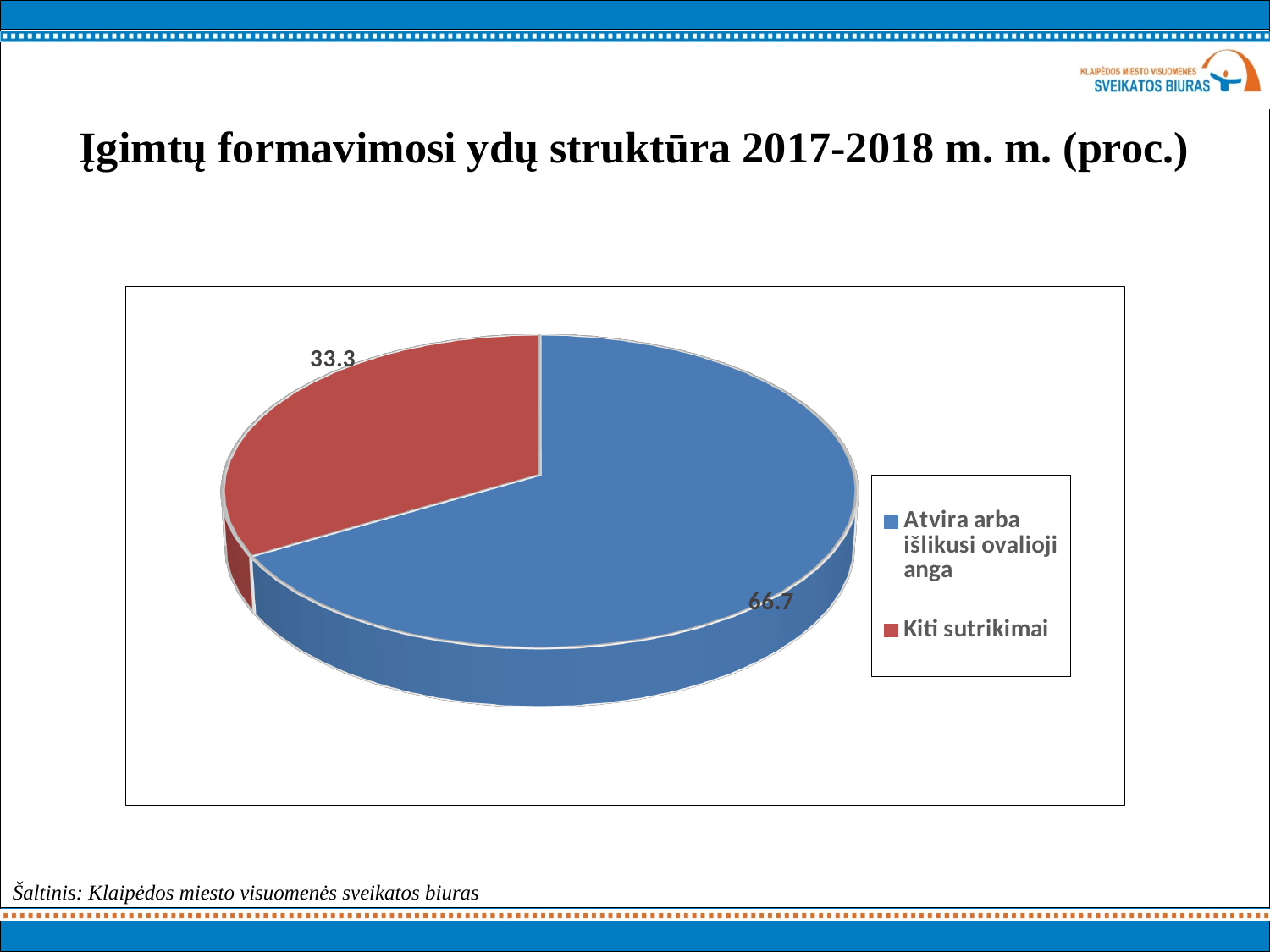
How many slices does the pie chart have? 2 What is the value for "Kiti sutrikimai"? 33.3 Which category has the smallest share of the pie? Kiti sutrikimai How many entries does the legend list? 2 Which is larger: the value for "Atvira arba išlikusi ovalioji anga" or for "Kiti sutrikimai"? Atvira arba išlikusi ovalioji anga What is the title of the slide containing the chart? Įgimtų formavimosi ydų struktūra 2017-2018 m. m. (proc.) What kind of chart is shown on the slide? pie chart What is the value for "Atvira arba išlikusi ovalioji anga"? 66.7 What is the difference between the values for "Atvira arba išlikusi ovalioji anga" and "Kiti sutrikimai"? 33.4 What colour is the slice for "Kiti sutrikimai"? red Which category has the largest share of the pie? Atvira arba išlikusi ovalioji anga